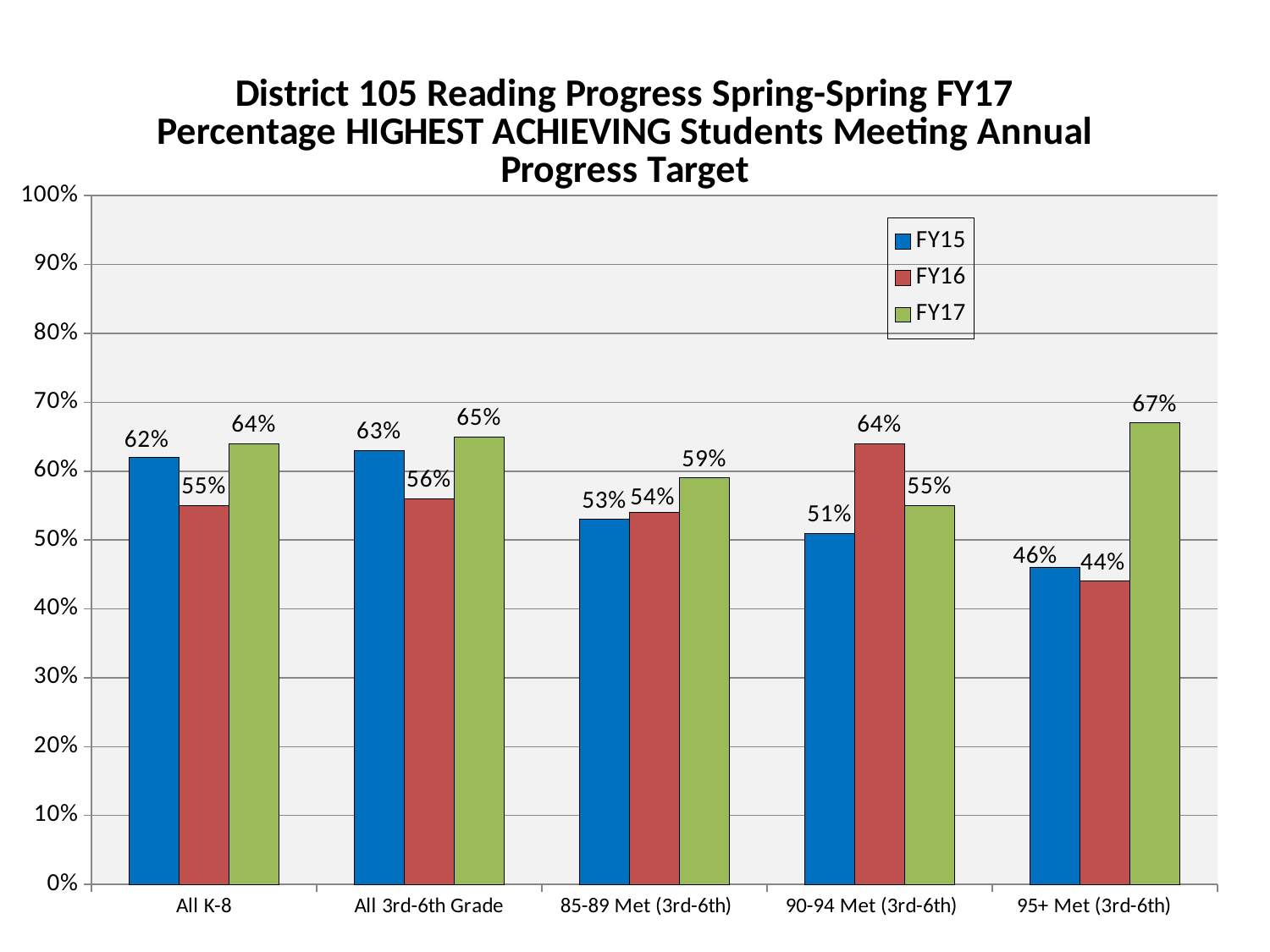
Which series is shown in green in the legend? FY17 What kind of chart is shown on the slide? bar chart How many series does the legend list? 3 What is the FY15 value for All K-8? 62% Which category has the lowest FY16 value? 95+ Met (3rd-6th) How many categories are shown on the x axis? 5 What is the FY17 value for 95+ Met (3rd-6th)? 67% Which is larger for 90-94 Met (3rd-6th): the FY16 value or the FY17 value? FY16 What is the difference between the FY17 and FY16 values for 95+ Met (3rd-6th)? 23% Is the FY15 value for 95+ Met (3rd-6th) greater or less than 50%? less What is the FY16 value for 90-94 Met (3rd-6th)? 64% Which category has the highest FY17 value? 95+ Met (3rd-6th)